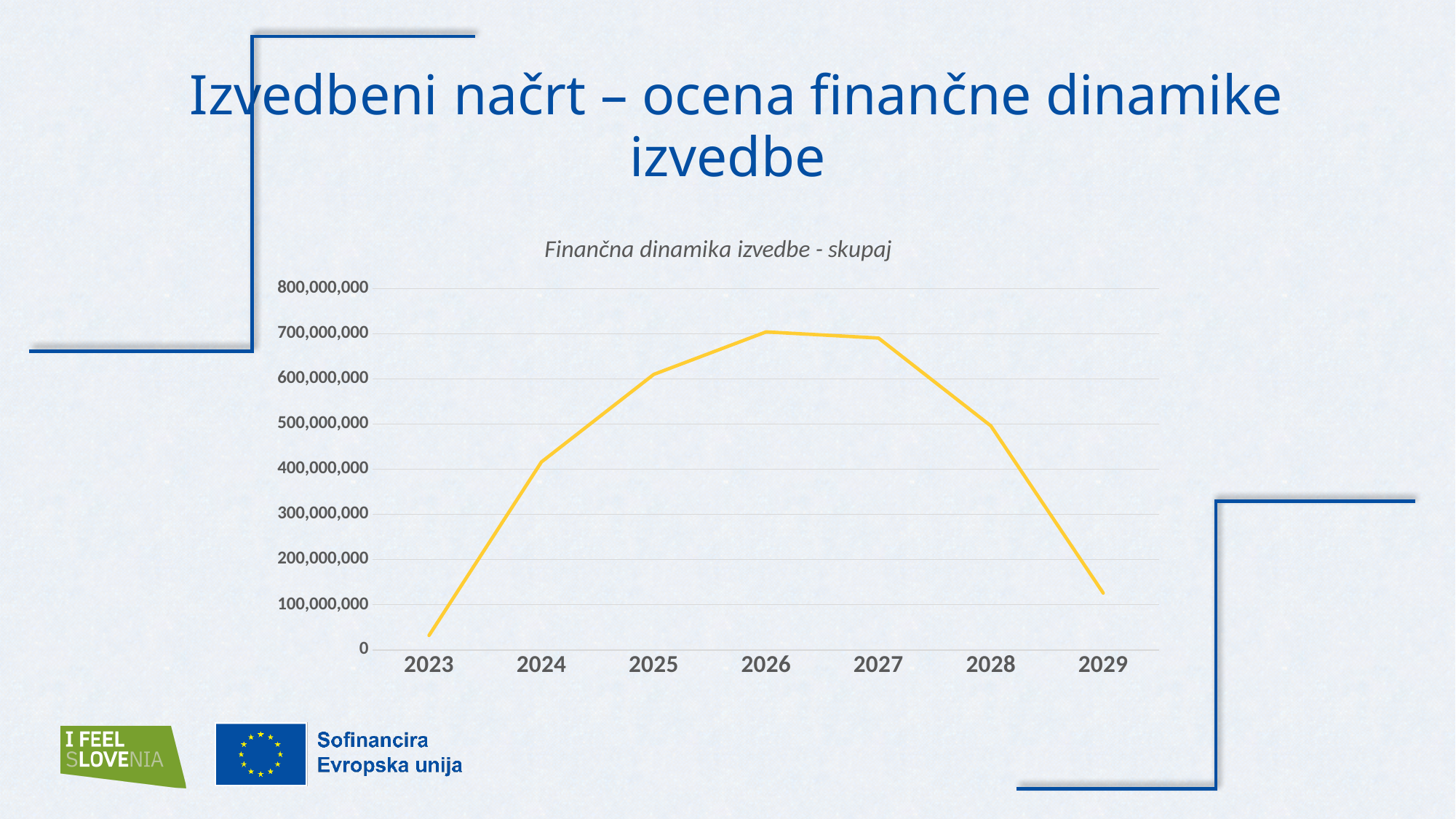
Is the value for 2023 greater or less than 100,000,000? less Is the value for 2029 greater or less than 100,000,000? greater What is the title of the chart? Finančna dinamika izvedbe - skupaj Which year has the lowest value in the chart? 2023 Is the value for 2024 greater or less than 500,000,000? less What kind of chart is shown on the slide? line chart How many years are plotted on the x axis of the chart? 7 Do the values rise or fall from 2023 to 2026? rise Which is larger, the value for 2025 or the value for 2028? 2025 Do the values rise or fall from 2027 to 2029? fall